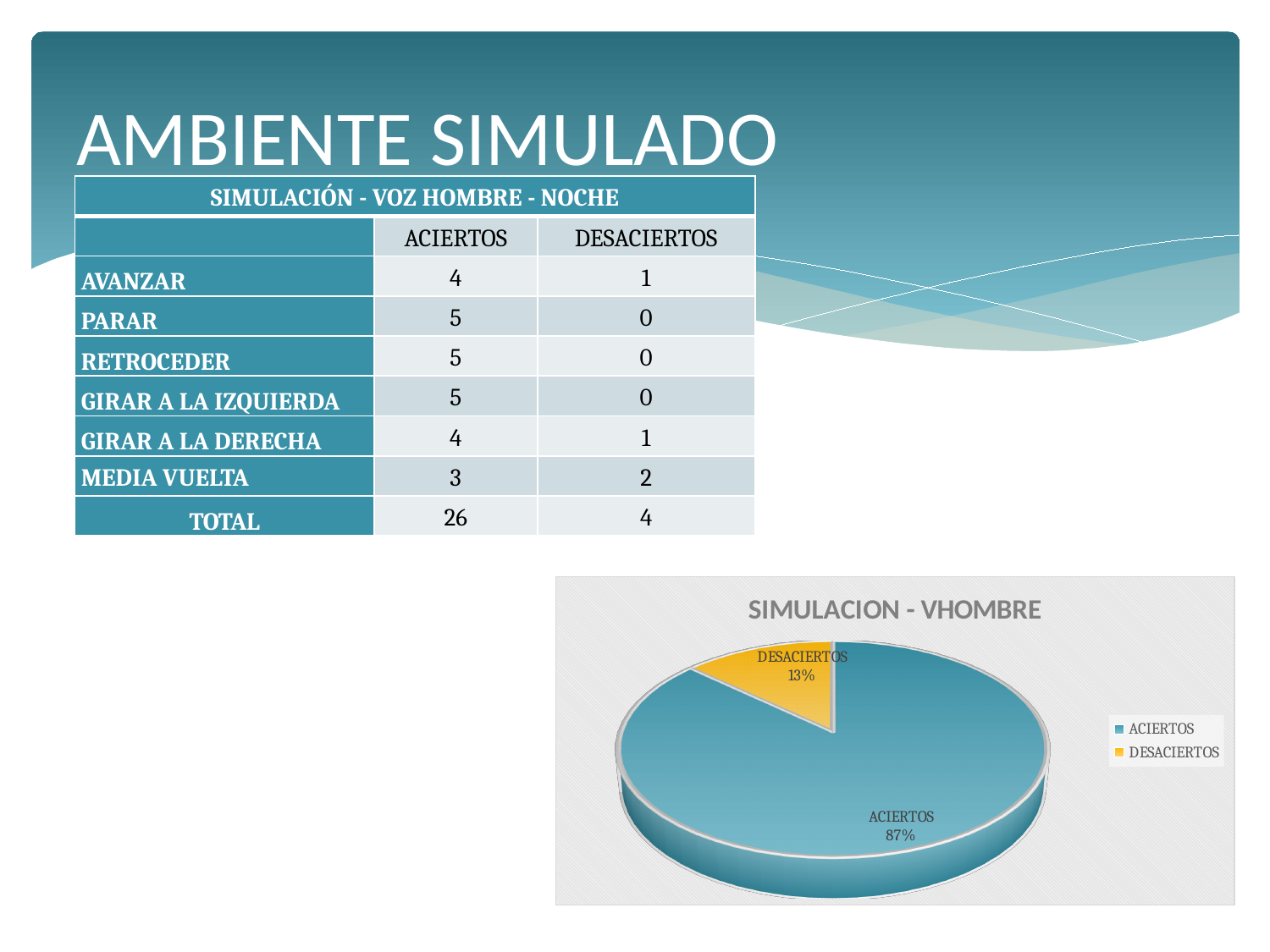
Which is larger, the ACIERTOS slice or the DESACIERTOS slice? ACIERTOS What share of the pie does ACIERTOS represent? 87% How many slices does the pie chart have? 2 How many entries does the chart legend list? 2 Which slice of the pie is the smallest? DESACIERTOS What is the title of the chart? SIMULACION - VHOMBRE What is the difference in percentage points between the ACIERTOS and DESACIERTOS slices? 74 What share of the pie does DESACIERTOS represent? 13% What colour is the DESACIERTOS slice in the pie chart? yellow Which slice of the pie is the largest? ACIERTOS What kind of chart is shown on the slide? pie chart